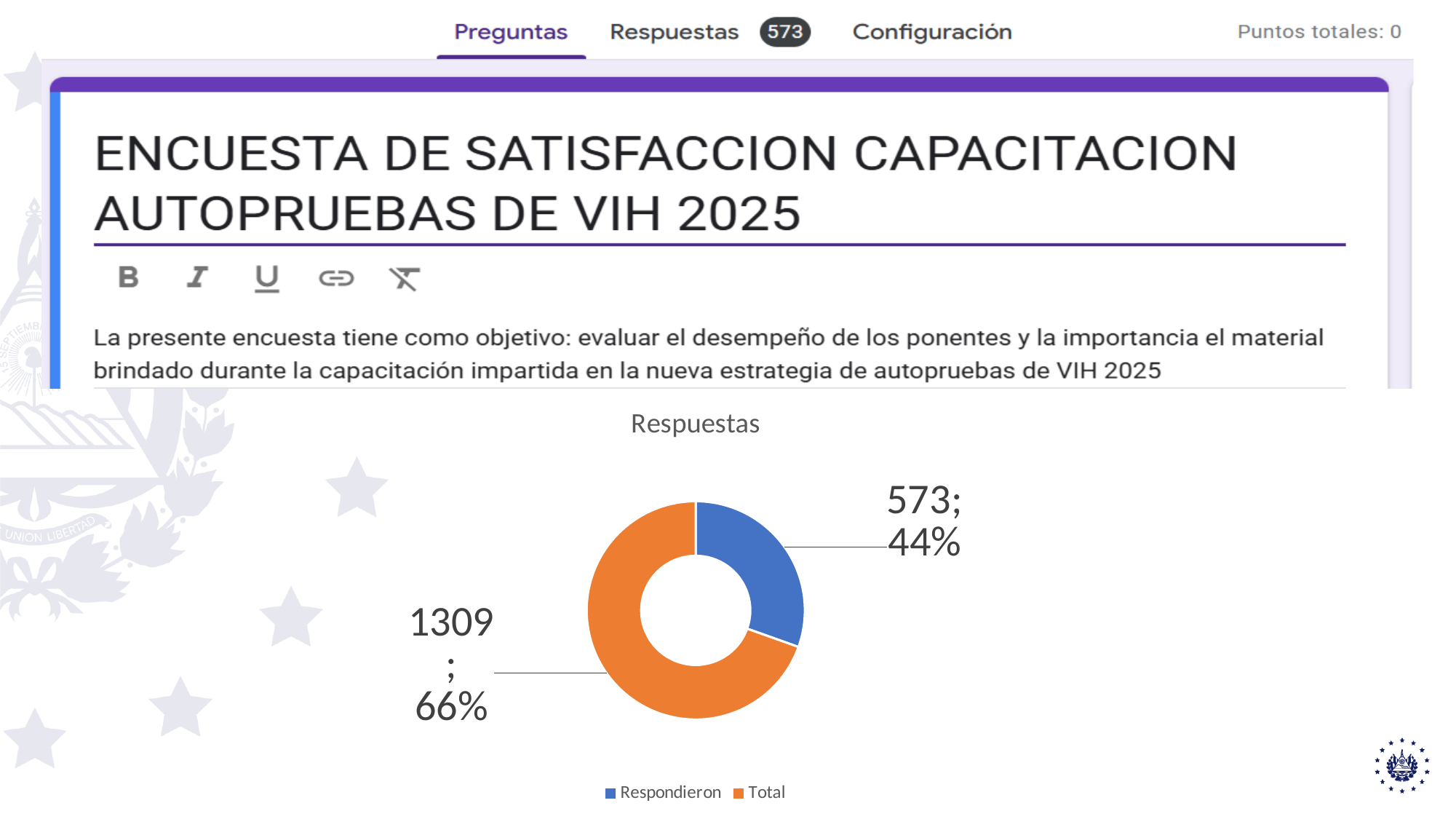
In the Respuestas chart, what value is shown for Total? 1309 In the Respuestas chart, what colour is the Respondieron slice? Blue In the Respuestas chart, what is the difference between the Total value and the Respondieron value? 736 What kind of chart is shown under the title "Respuestas"? Doughnut chart In the Respuestas chart, what percentage is shown for the Respondieron slice? 44% In the Respuestas chart, what percentage is shown for the Total slice? 66% In the Respuestas chart, which category has the largest slice? Total In the Respuestas chart, what value is shown for Respondieron? 573 In the Respuestas chart, which category has the smallest slice? Respondieron In the Respuestas chart, which is larger, Respondieron or Total? Total What is the title of the chart on the slide? Respuestas How many slices does the Respuestas chart have? 2